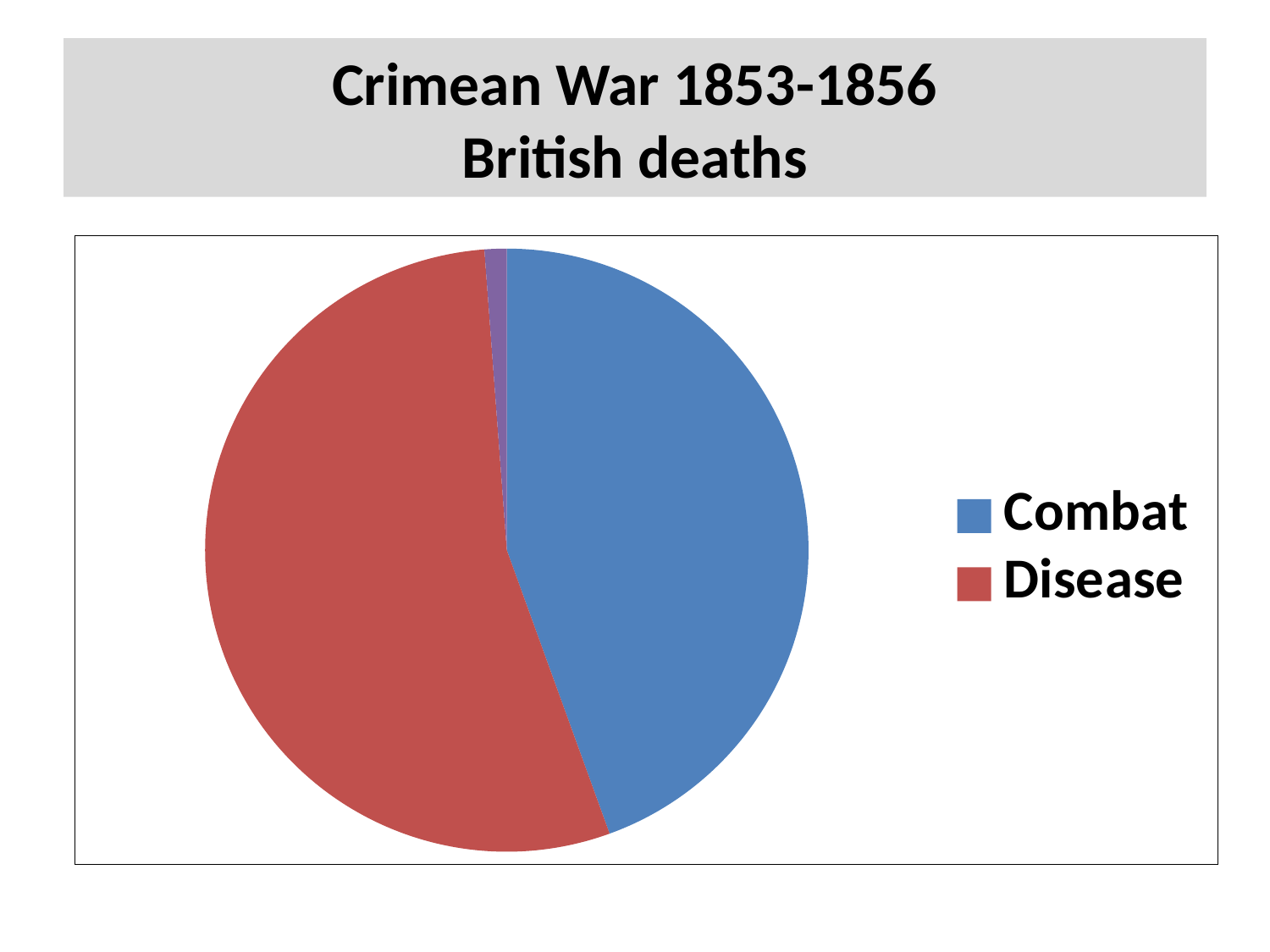
What is the title shown above the pie chart? Crimean War 1853-1856 British deaths Which category has the smaller slice of the pie chart, Combat or Disease? Combat What kind of chart is shown on the slide? pie chart How many entries does the legend of the pie chart list? 2 Which slice is larger, Combat or Disease? Disease What colour is the Combat slice in the pie chart? blue Which category has the largest slice of the pie chart? Disease